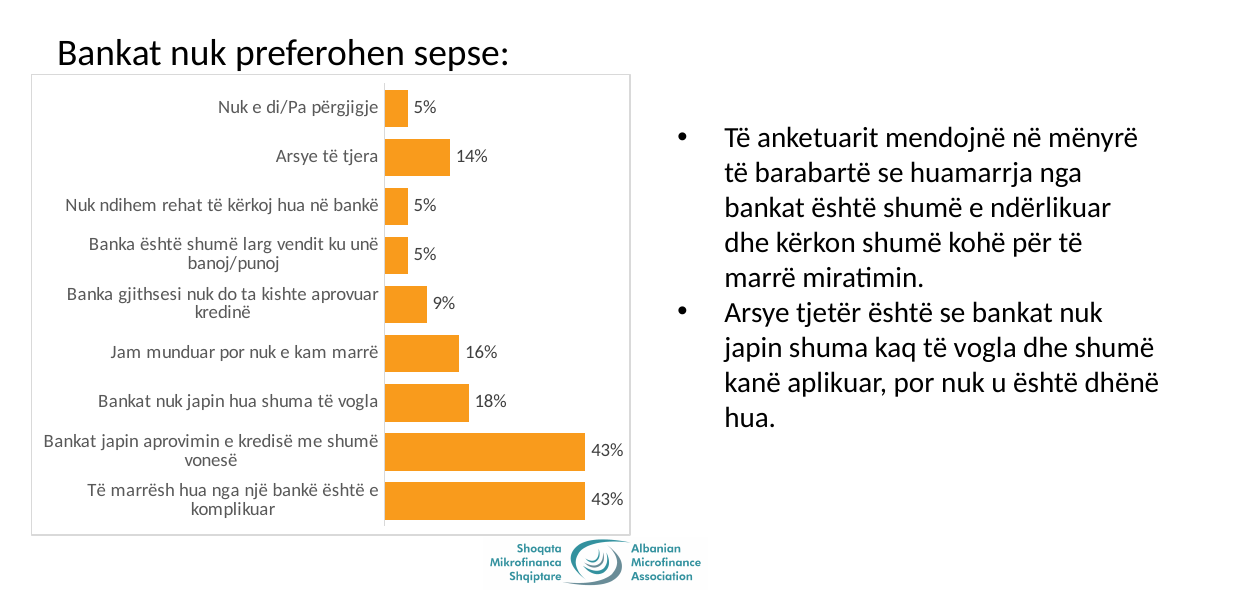
What is the value for "Bankat nuk japin hua shuma të vogla"? 18% What is the title of the chart? Bankat nuk preferohen sepse: Which is larger: the value for "Jam munduar por nuk e kam marrë" or the value for "Arsye të tjera"? Jam munduar por nuk e kam marrë What is the value for "Arsye të tjera"? 14% What is the value for "Jam munduar por nuk e kam marrë"? 16% What is the lowest value shown in the chart? 5% What kind of chart is shown on the slide? bar chart How many categories does the chart show? 9 What is the highest value shown in the chart? 43% What is the difference between the values for "Arsye të tjera" and "Nuk e di/Pa përgjigje"? 9% What is the difference between the values for "Bankat japin aprovimin e kredisë me shumë vonesë" and "Bankat nuk japin hua shuma të vogla"? 25% What is the value for "Banka gjithsesi nuk do ta kishte aprovuar kredinë"? 9%